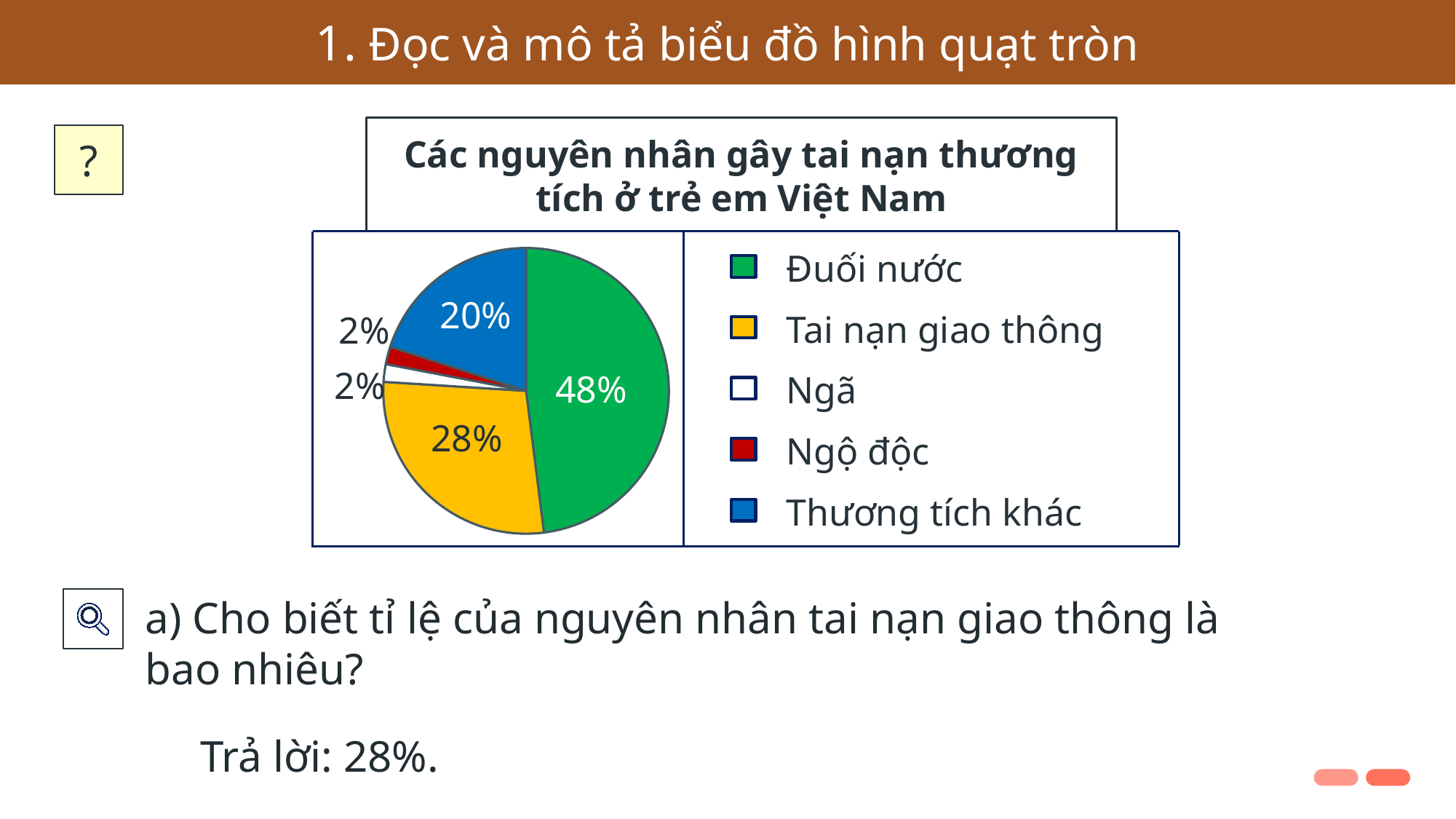
What kind of chart is shown on the slide? pie chart Which is larger, the slice for Tai nạn giao thông or the slice for Thương tích khác? Tai nạn giao thông What percentage is shown for Tai nạn giao thông? 28% What is the chart's title? Các nguyên nhân gây tai nạn thương tích ở trẻ em Việt Nam What percentage is shown for Thương tích khác? 20% What is the combined share of Ngã and Ngộ độc? 4% What percentage is shown for Ngộ độc? 2% How many categories does the legend list? 5 Which category has the largest slice of the pie? Đuối nước What is the difference between the Đuối nước and Tai nạn giao thông percentages? 20% What percentage is shown for Đuối nước? 48% What colour is the slice for Thương tích khác? blue